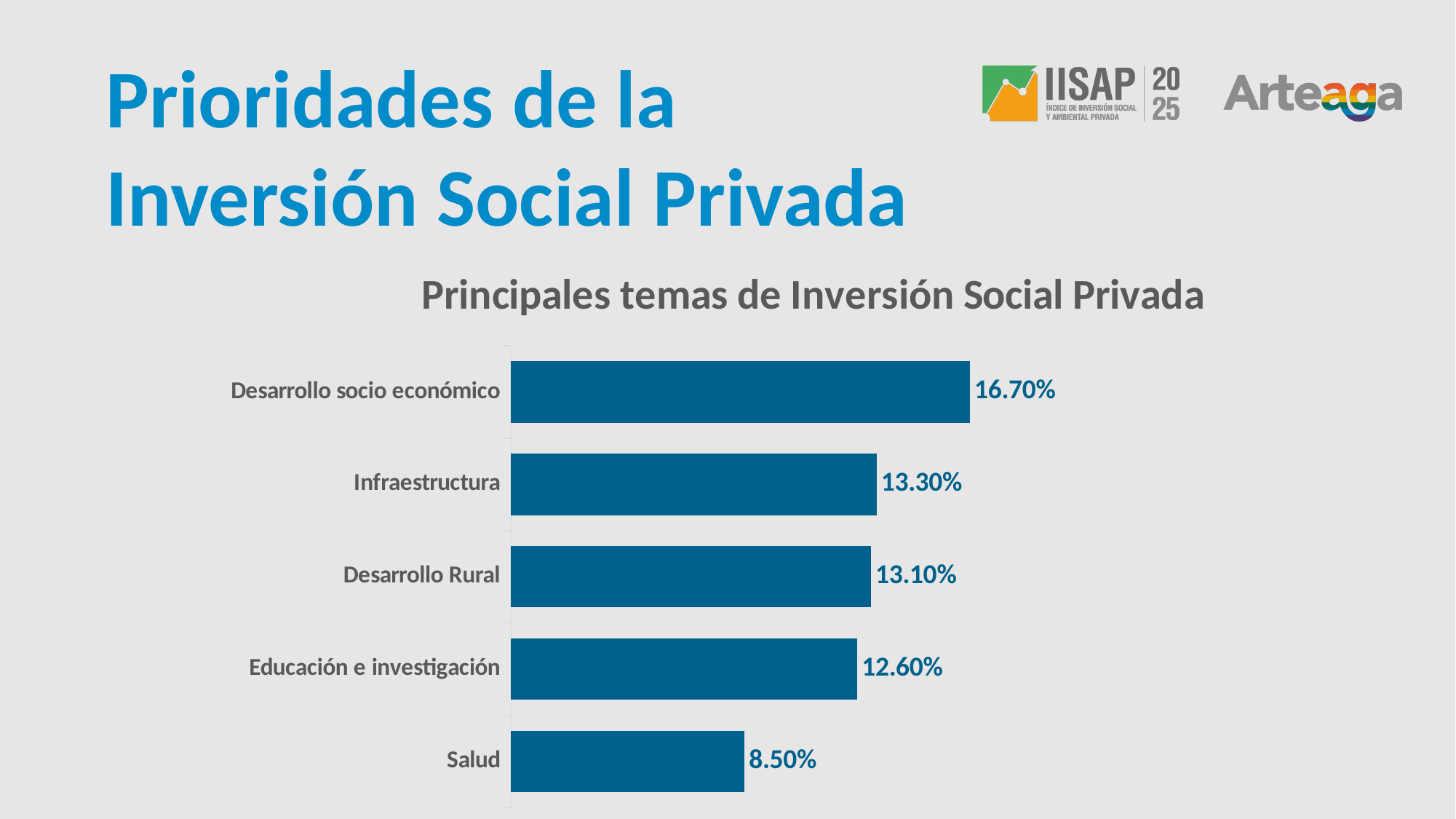
What kind of chart is shown on the slide? Bar chart What is the difference between Desarrollo socio económico and Salud? 8.20% What is the value for Educación e investigación? 12.60% Which category has the lowest value? Salud What is the value for Salud? 8.50% What is the difference between Infraestructura and Desarrollo Rural? 0.20% What is the value for Infraestructura? 13.30% What is the title of the chart? Principales temas de Inversión Social Privada Which is larger, Desarrollo Rural or Educación e investigación? Desarrollo Rural What is the value for Desarrollo socio económico? 16.70% Which category has the highest value? Desarrollo socio económico How many categories are shown in the chart? 5